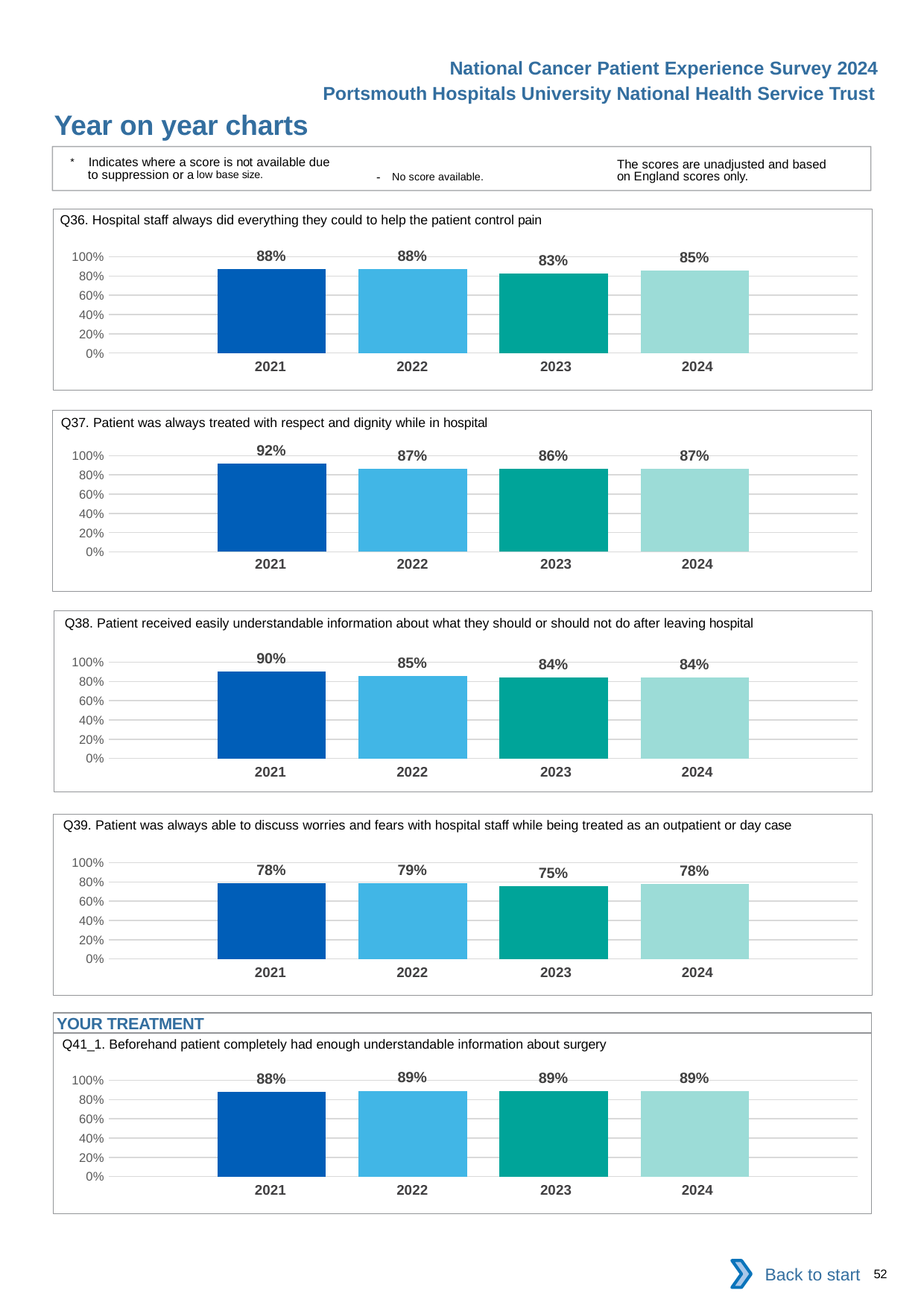
In the Q39 chart, is the value for 2022 larger or smaller than the value for 2023? larger In the Q36 chart (Hospital staff always did everything they could to help the patient control pain), what is the value for 2023? 83% What kind of chart is the Q38 chart? bar chart In the Q38 chart (Patient received easily understandable information about what they should or should not do after leaving hospital), what is the difference between the 2021 and 2024 values? 6 percentage points In the Q39 chart (Patient was always able to discuss worries and fears with hospital staff), which year has the lowest value? 2023 In the Q37 chart, what is the value for 2024? 87% In the Q37 chart, is the value for 2022 greater or less than 80%? greater How many years are shown on the x axis of the Q36 chart? 4 In the Q41_1 chart (Beforehand patient completely had enough understandable information about surgery), what is the value for 2021? 88% What is the section heading shown above the Q41_1 chart? YOUR TREATMENT In the Q36 chart, what is the difference between the 2022 and 2023 values? 5 percentage points In the Q37 chart (Patient was always treated with respect and dignity while in hospital), which year has the highest value? 2021